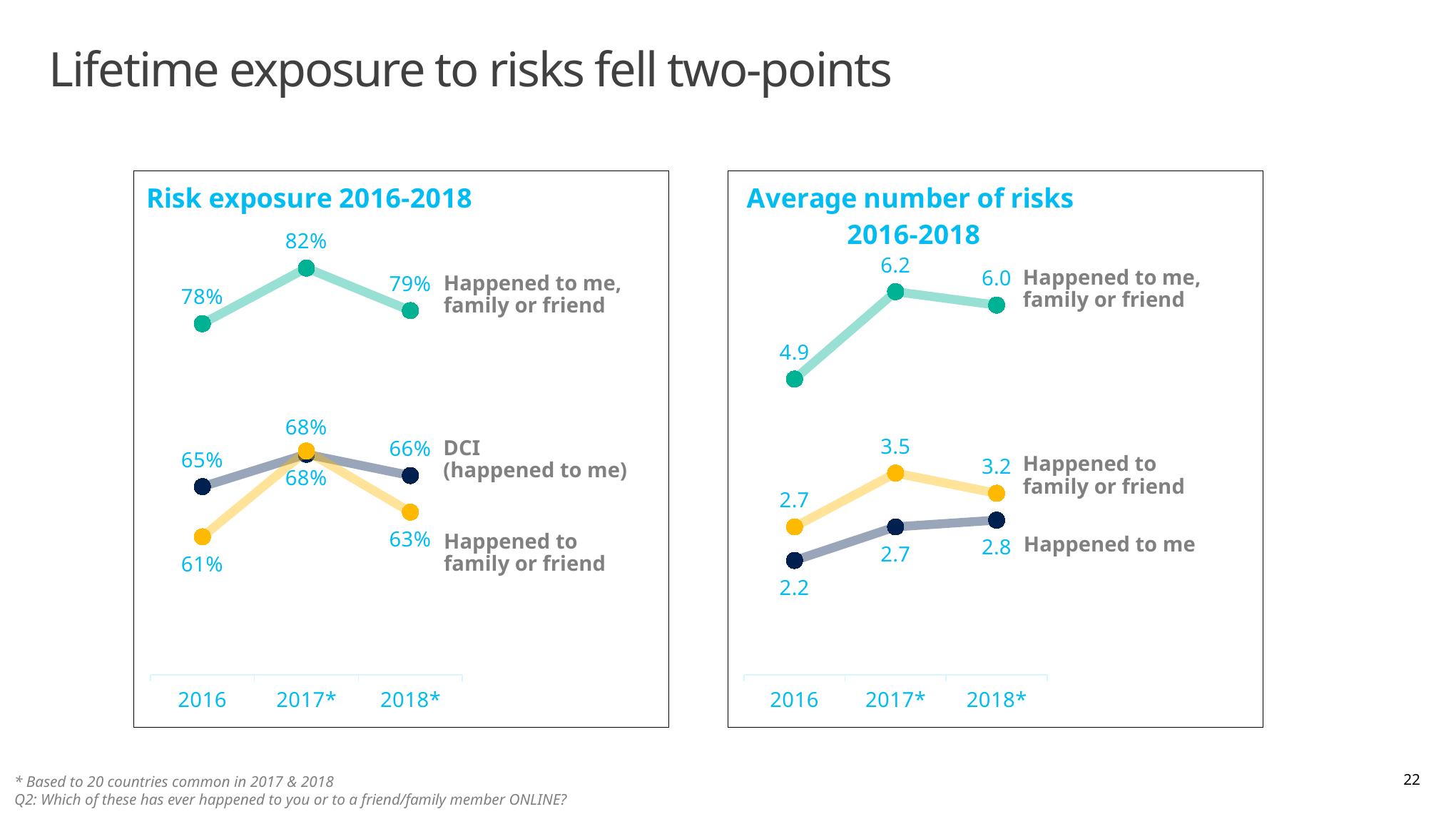
In the 'Risk exposure 2016-2018' chart, in which year is 'Happened to me, family or friend' highest? 2017* In the 'Risk exposure 2016-2018' chart, what is the value for 'DCI (happened to me)' in 2018*? 66% What kind of chart is 'Average number of risks 2016-2018'? line chart In the 'Risk exposure 2016-2018' chart, what is the difference between the 2017* and 2018* values for 'DCI (happened to me)'? 2% In the 'Risk exposure 2016-2018' chart, what is the value for 'Happened to me, family or friend' in 2017*? 82% In the 'Risk exposure 2016-2018' chart, how many series are plotted? 3 In the 'Risk exposure 2016-2018' chart, what is the value for 'Happened to family or friend' in 2016? 61% In the 'Average number of risks 2016-2018' chart, what is the difference between the 2016 and 2017* values for 'Happened to me, family or friend'? 1.3 In the 'Average number of risks 2016-2018' chart, what is the value for 'Happened to family or friend' in 2017*? 3.5 In the 'Average number of risks 2016-2018' chart, does 'Happened to me' rise or fall from 2016 to 2018*? rise In the 'Average number of risks 2016-2018' chart, which is larger in 2018*: 'Happened to family or friend' or 'Happened to me'? Happened to family or friend In the 'Average number of risks 2016-2018' chart, what is the value for 'Happened to me' in 2016? 2.2